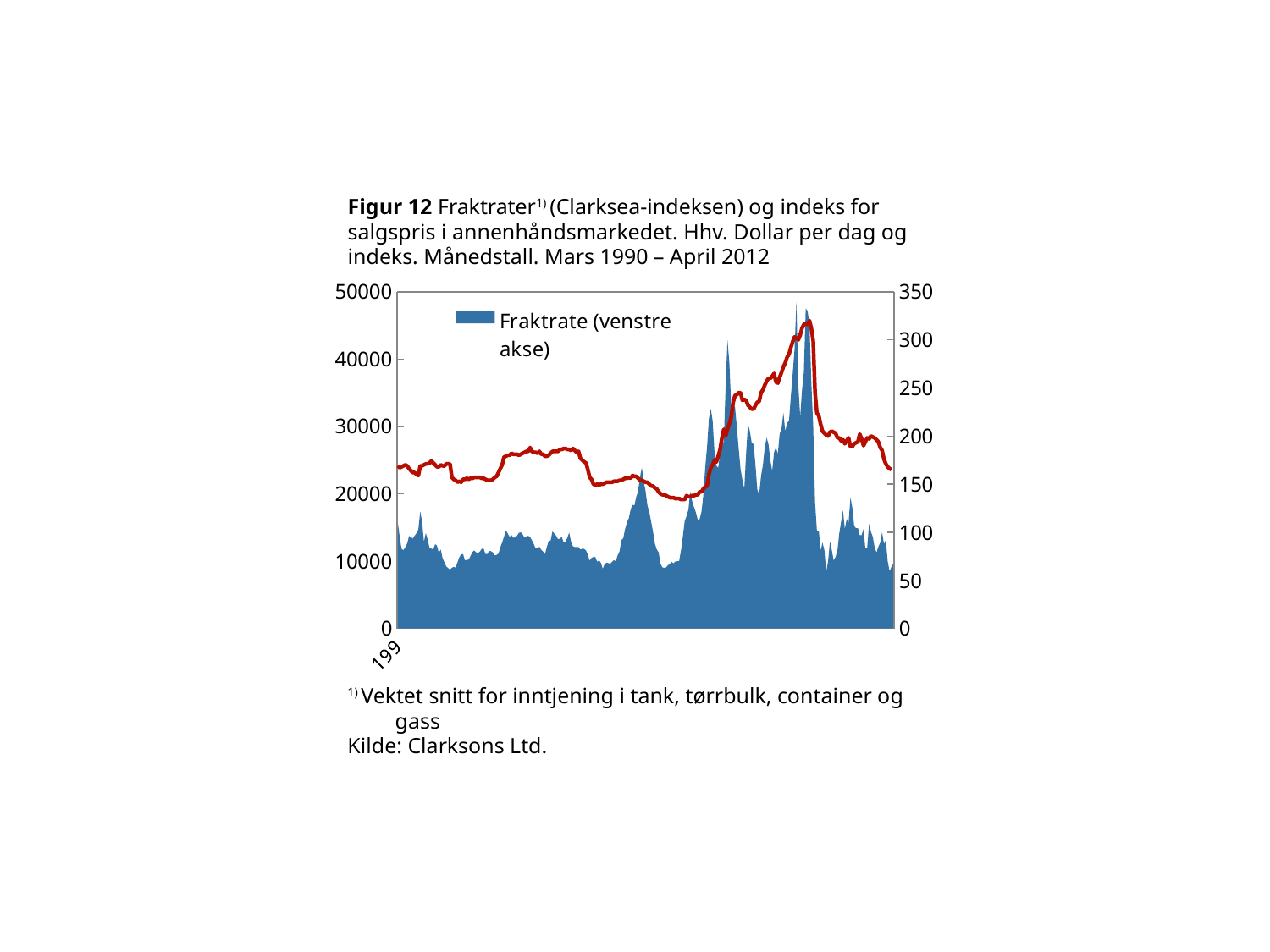
Is the lowest point of the red index line (right axis) greater or less than 150? less Is the peak value of the Fraktrate series greater or less than 50000? less What is the series name shown in the legend? Fraktrate (venstre akse) Is the lowest value of the Fraktrate series greater or less than 10000? less What is the highest tick value on the left axis? 50000 What kind of chart is shown on the slide? Area chart with a line How many series does the legend list? 1